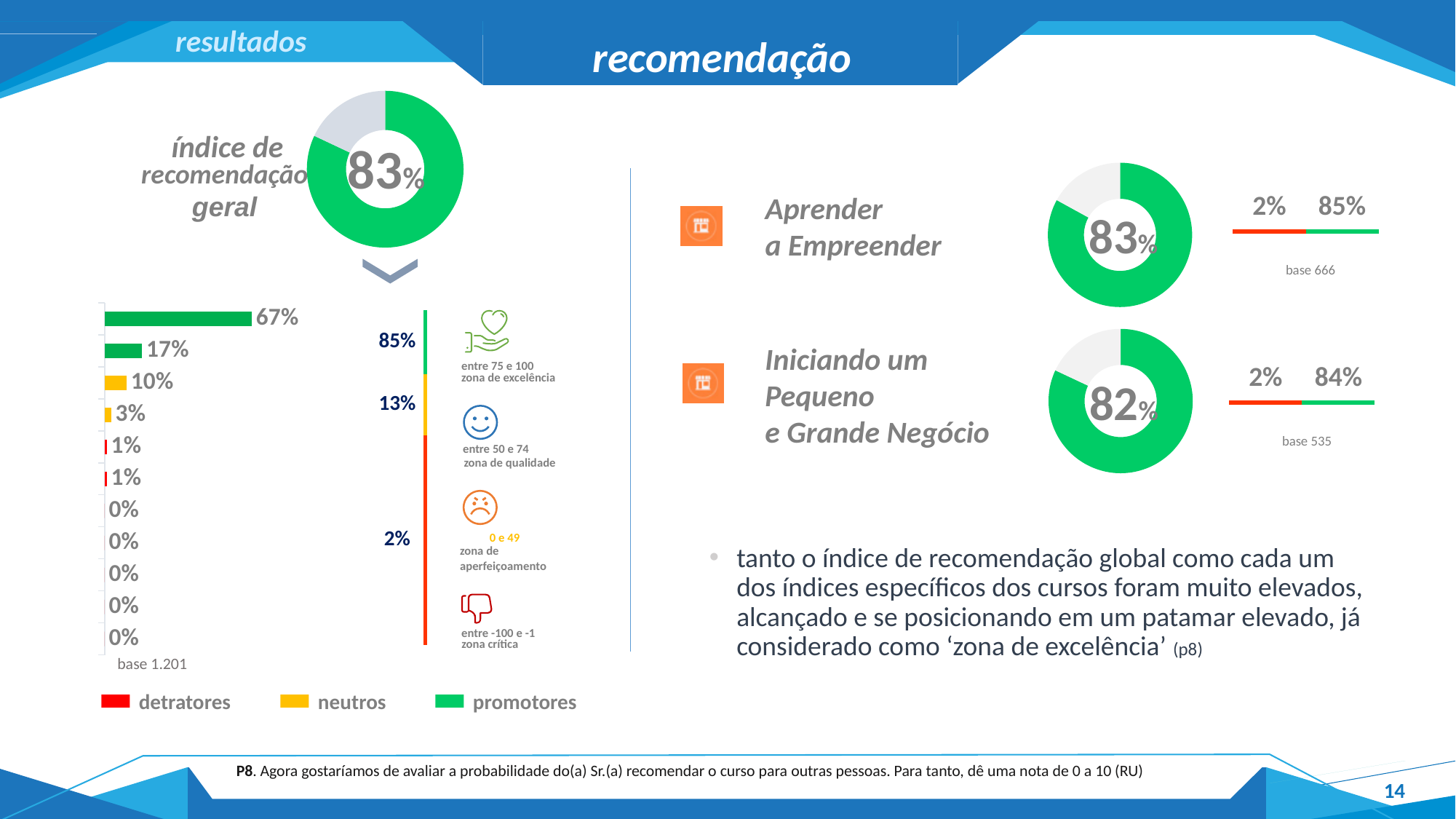
How many bars (categories) are shown in the horizontal bar chart on the left? 11 What is the total of the three segments (85%, 13%, 2%) in the stacked vertical bar? 100% Which of the two course donut charts shows the higher value, 'Aprender a Empreender' or 'Iniciando um Pequeno e Grande Negócio'? Aprender a Empreender What value is shown in the centre of the donut chart for 'Iniciando um Pequeno e Grande Negócio'? 82% How many entries does the legend below the horizontal bar chart list? 3 In the stacked vertical bar next to the horizontal bar chart, what is the value of the green (promotores) segment? 85% What kind of chart is the chart on the left with the values 67%, 17% and 10%? bar chart What is the difference between the donut values for 'Aprender a Empreender' and 'Iniciando um Pequeno e Grande Negócio'? 1% What value is shown in the centre of the 'índice de recomendação geral' donut chart? 83% In the stacked vertical bar next to the horizontal bar chart, what is the value of the yellow (neutros) segment? 13% In the horizontal bar chart on the left, what is the highest value shown? 67% What value is shown in the centre of the donut chart for 'Aprender a Empreender'? 83%